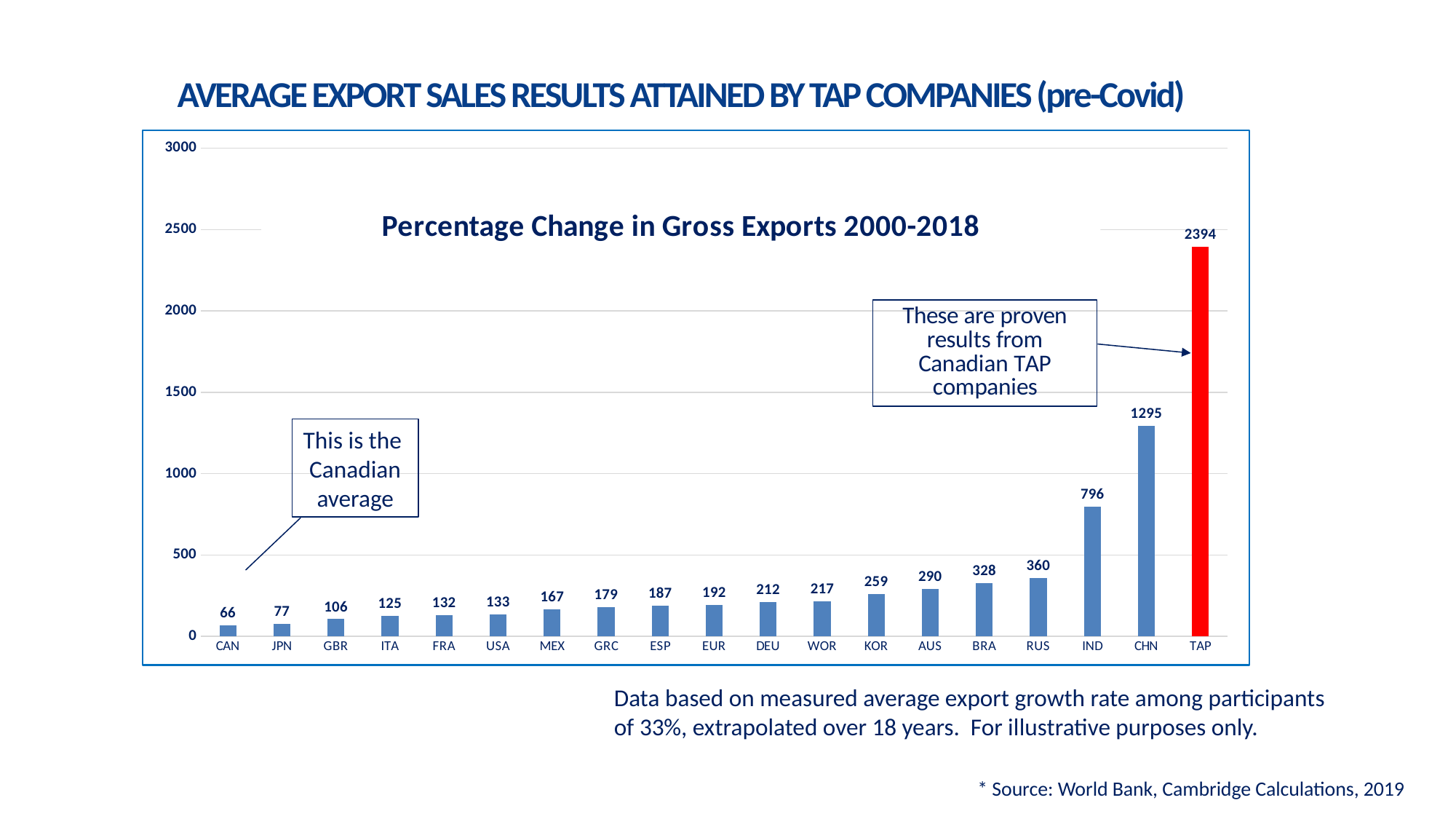
Which category has the lowest value? CAN Which is larger, the value for RUS or the value for BRA? RUS What is the title of the chart? Percentage Change in Gross Exports 2000-2018 What is the value for IND? 796 What is the value for CAN? 66 Is the value for TAP greater or less than 2000? greater How many categories are shown on the x axis? 19 Which category has the highest value? TAP Do the values rise or fall from left to right along the x axis? rise What is the value for CHN? 1295 What kind of chart is shown? bar chart What is the difference between the values for TAP and CHN? 1099